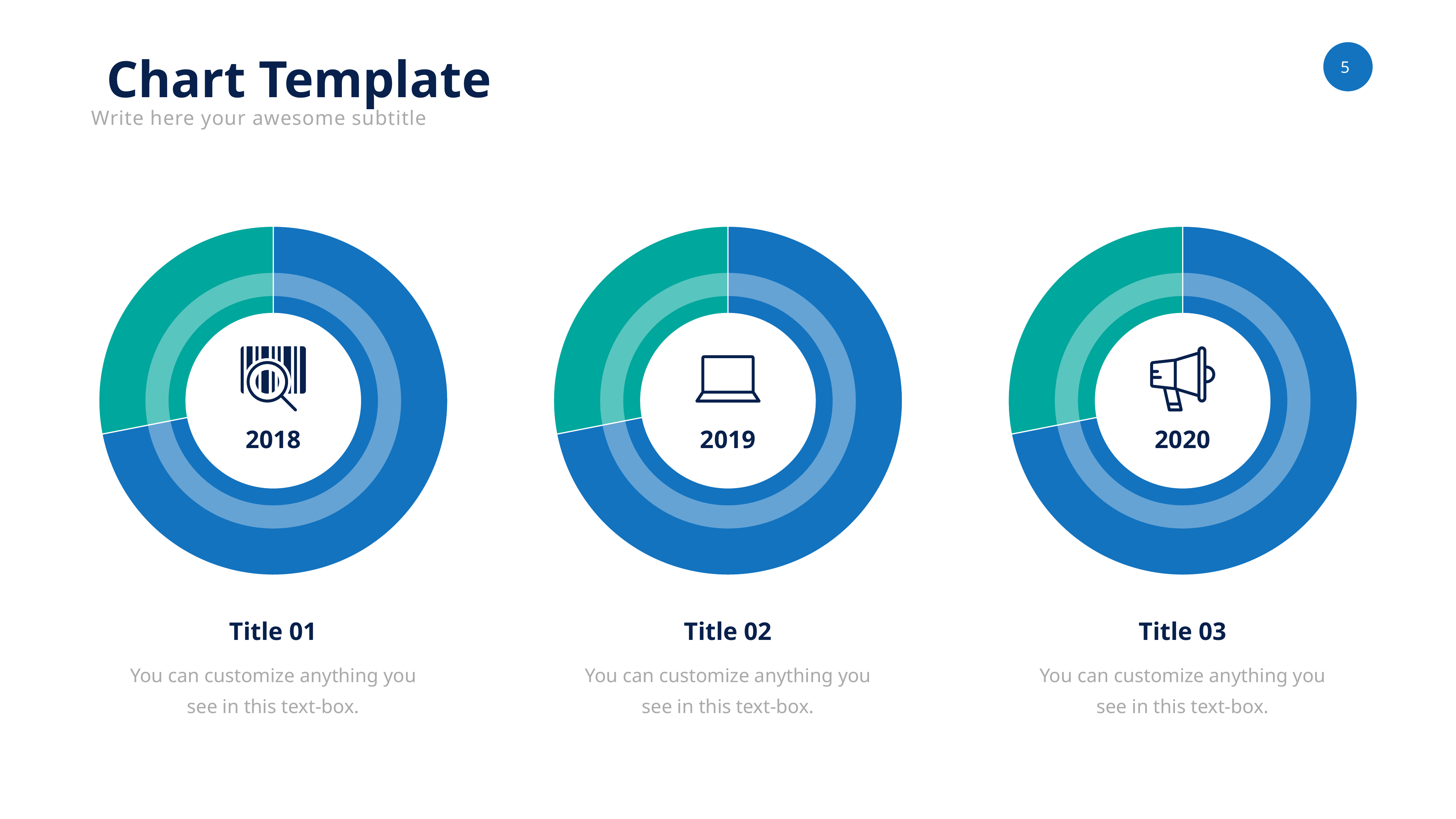
How many doughnut charts are on the slide? 3 What is the title printed below the chart labelled 2020? Title 03 What kind of chart is shown under Title 01? Doughnut chart In the 2020 chart, which colour slice is the smallest? Teal In the 2019 chart, which slice is larger, the blue one or the teal one? The blue one In the 2018 chart, which colour slice is the largest? Blue In the 2019 chart, how many rings does the doughnut have? 2 In the 2018 chart, how many slices does the outer ring have? 2 In the 2018 chart, which slice is larger, the blue one or the teal one? The blue one In the 2020 chart, which slice is larger, the blue one or the teal one? The blue one What year is shown in the centre of the chart under Title 02? 2019